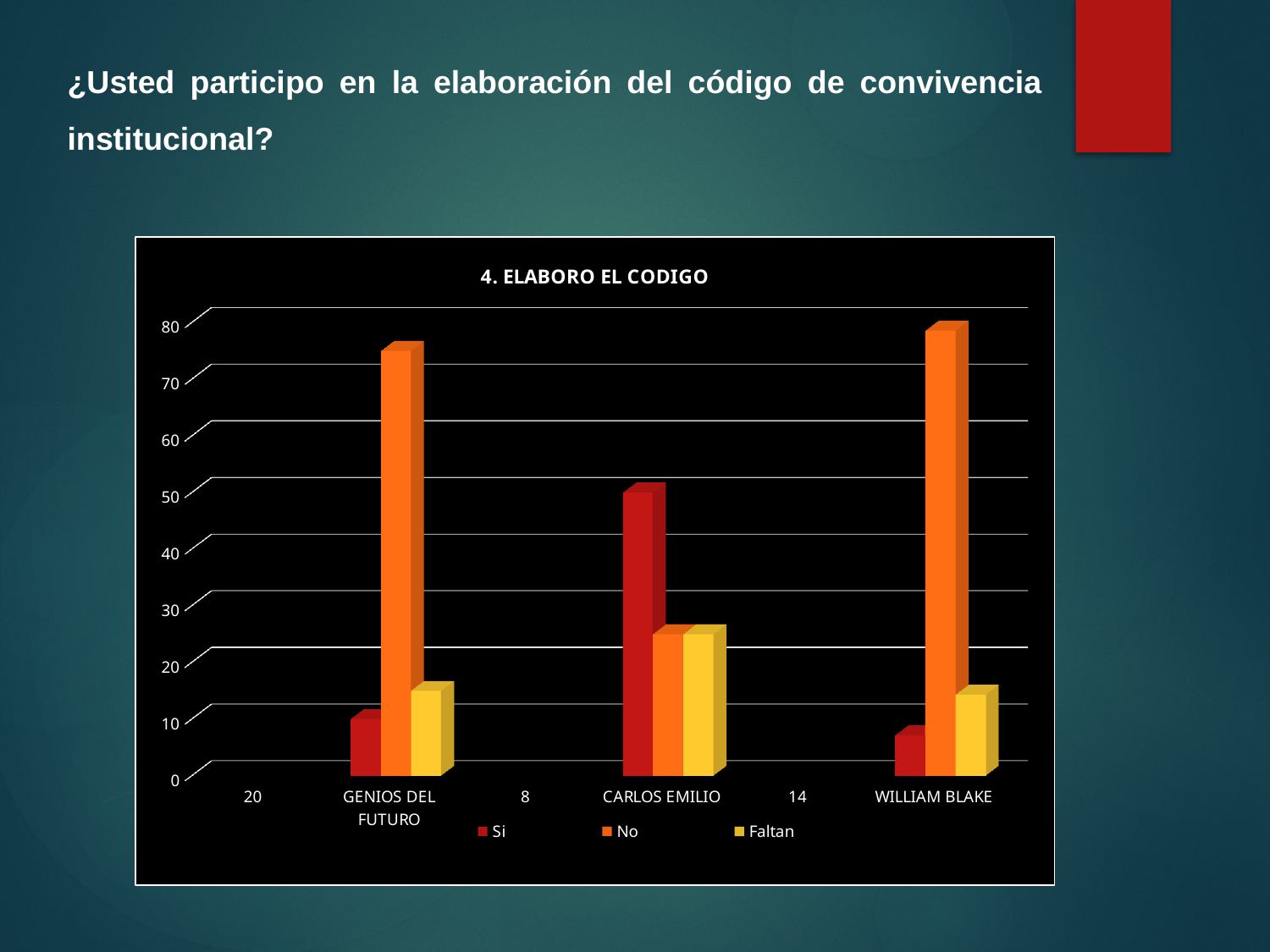
What kind of chart is shown on the slide? bar chart Is the No value for WILLIAM BLAKE greater or less than 70? greater For GENIOS DEL FUTURO, which is larger: the Si value or the No value? No Is the Si value for GENIOS DEL FUTURO greater or less than 20? less For CARLOS EMILIO, which is larger: the Si value or the No value? Si What are the series names listed in the legend? Si, No, Faltan Is the Si value for CARLOS EMILIO greater or less than 40? greater What is the title of the chart? 4. ELABORO EL CODIGO How many series does the chart's legend list? 3 Which category has the highest value for the Si series? CARLOS EMILIO